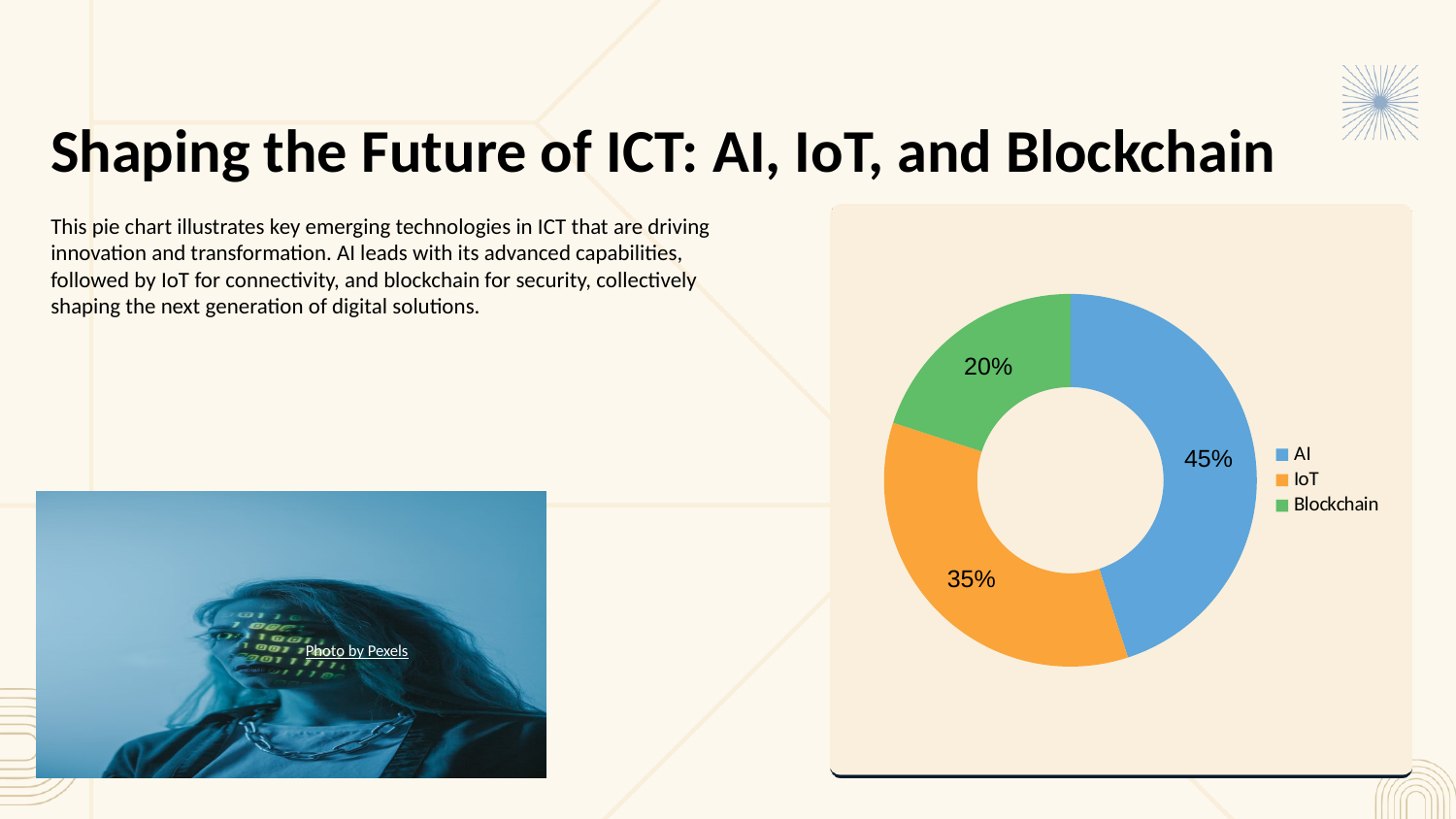
Which slice is larger, IoT or Blockchain? IoT What is the difference in percentage points between the AI slice and the IoT slice? 10 What share of the pie chart does IoT account for? 35% What share of the pie chart does Blockchain account for? 20% How many categories are shown in the pie chart? 3 Which category is shown in green in the pie chart? Blockchain What share of the pie chart does AI account for? 45% What kind of chart is shown on the slide? Pie chart What is the difference in percentage points between the IoT slice and the Blockchain slice? 15 Which category has the smallest slice in the pie chart? Blockchain What colour is the AI slice in the pie chart? Blue Which category has the largest slice in the pie chart? AI